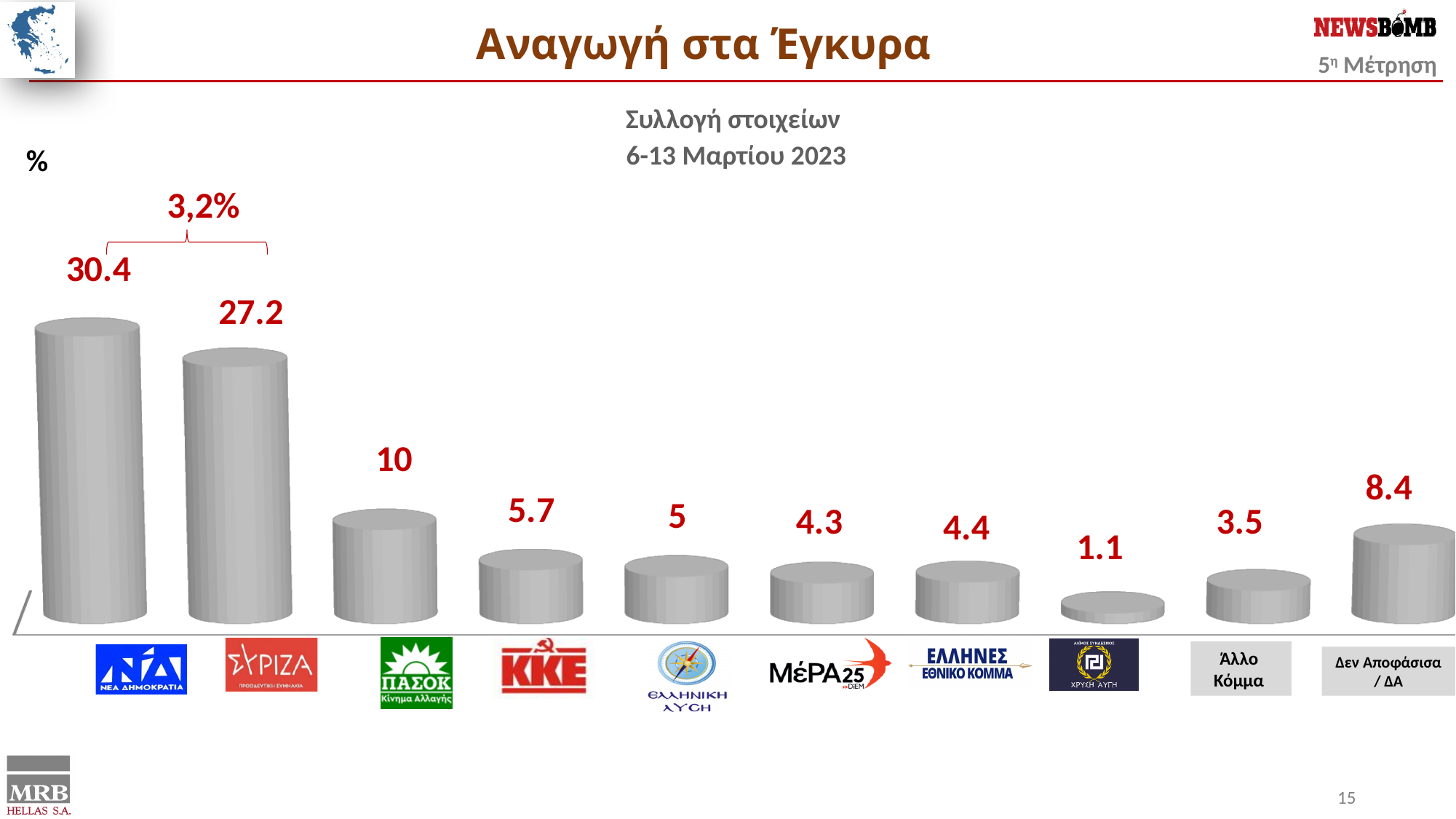
How many categories are shown on the chart? 10 What is the value shown for ΣΥΡΙΖΑ? 27.2 What is the value shown for ΠΑΣΟΚ? 10 What is the difference between the values for ΝΕΑ ΔΗΜΟΚΡΑΤΙΑ and ΣΥΡΙΖΑ? 3,2% Which is larger, the value for ΚΚΕ or the value for ΕΛΛΗΝΙΚΗ ΛΥΣΗ? ΚΚΕ Which party has the highest value on the chart? ΝΕΑ ΔΗΜΟΚΡΑΤΙΑ What is the difference between the values for ΠΑΣΟΚ and ΚΚΕ? 4.3 Which category has the lowest value on the chart? ΧΡΥΣΗ ΑΥΓΗ What is the value shown for ΝΕΑ ΔΗΜΟΚΡΑΤΙΑ? 30.4 What is the value shown for Δεν Αποφάσισα / ΔΑ? 8.4 What kind of chart is shown on the slide? Bar chart What is the value shown for ΚΚΕ? 5.7